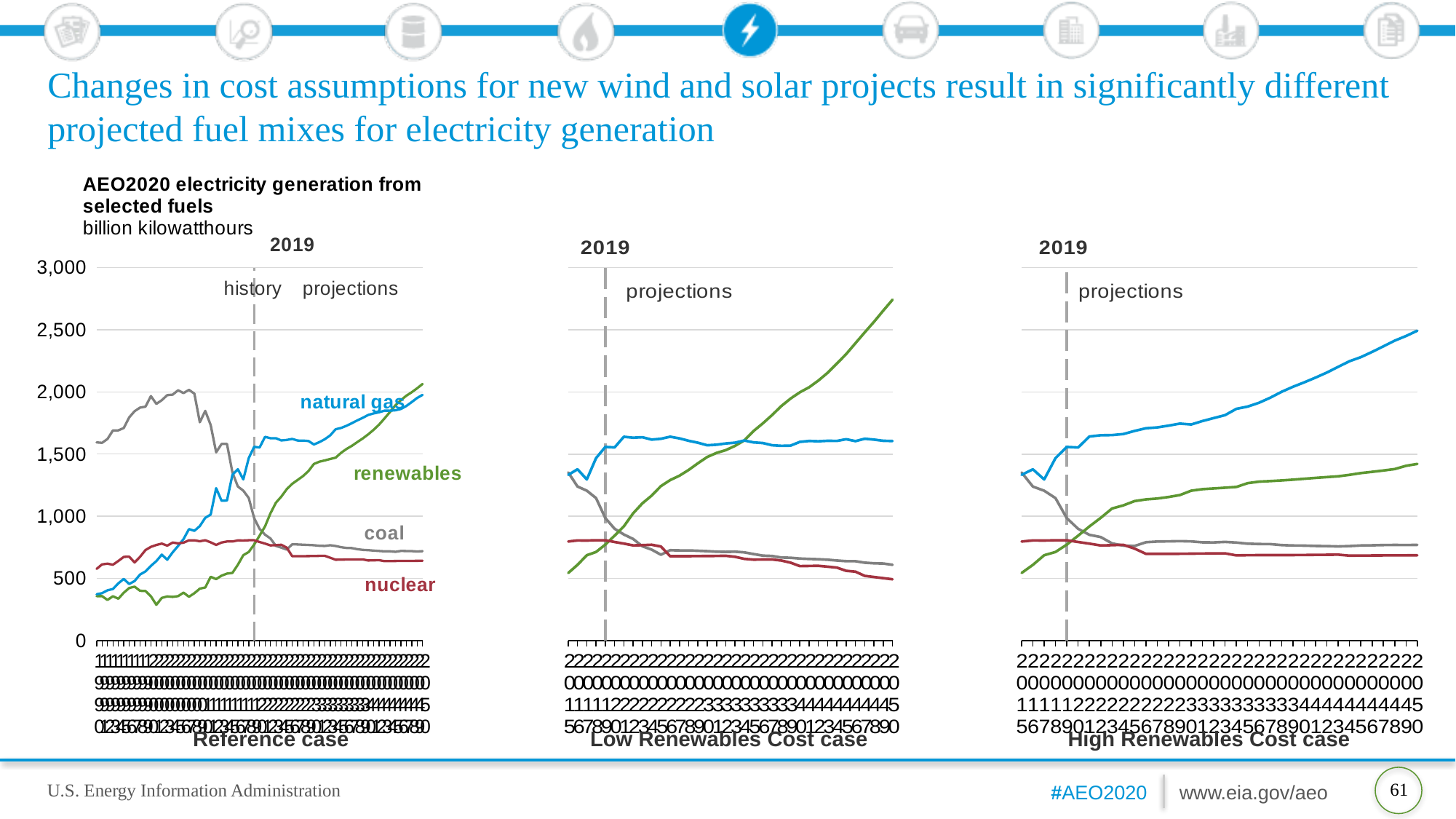
In the Low Renewables Cost case chart, which fuel has the lowest generation at the end of the projection period? nuclear In the Low Renewables Cost case chart, does nuclear generation rise or fall over the projection period? fall What kind of chart is used in the Reference case panel? line chart In the Reference case chart, how many fuel series are plotted? 4 In the High Renewables Cost case chart, does natural gas generation rise or fall over the projection period? rise What unit is used for the values in the charts? billion kilowatthours In the High Renewables Cost case chart, is the value for natural gas at the end of the projection greater or less than 2,000? greater In the Low Renewables Cost case chart, is the value for renewables at the end of the projection greater or less than 2,500? greater In the Reference case chart, which is larger at the end of the projection period, coal or nuclear? coal In the High Renewables Cost case chart, which fuel has the highest generation at the end of the projection period? natural gas In the Reference case chart, is the value for natural gas at the end of the projection greater or less than 1,500? greater In the Low Renewables Cost case chart, which fuel has the highest generation at the end of the projection period? renewables